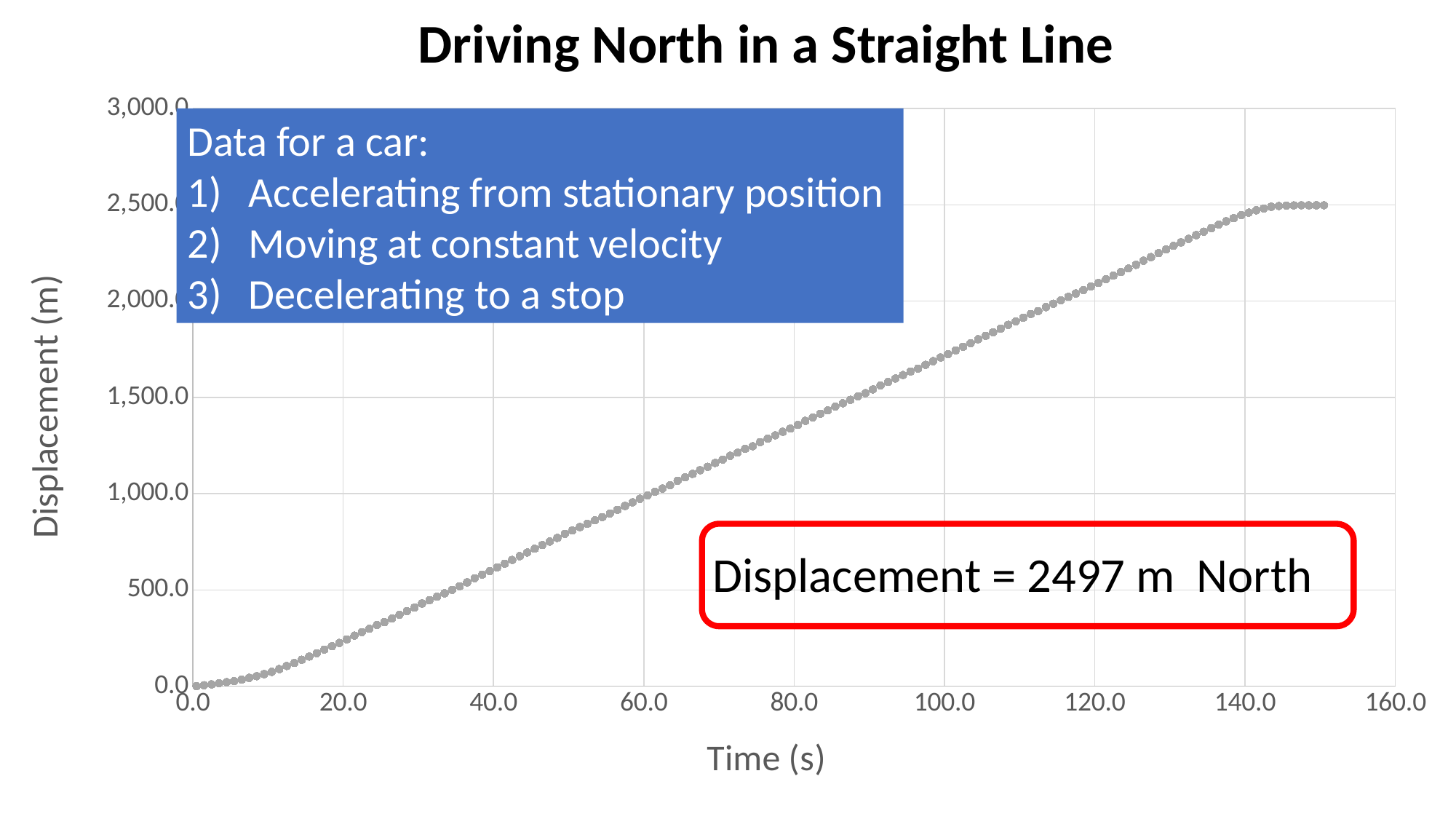
Is the displacement at 40.0 s greater or less than 500.0 m? greater Is the displacement at 100.0 s greater or less than 1,500.0 m? greater According to the annotation on the chart, what is the final displacement of the car? 2497 m North What kind of chart is shown on the slide? scatter chart Is the displacement at 80.0 s greater or less than 1,500.0 m? less Do the plotted displacement values rise or fall as time increases along the x axis? rise Which is larger, the displacement at 60.0 s or the displacement at 120.0 s? 120.0 s What is the label of the vertical axis? Displacement (m) What is the title of the chart? Driving North in a Straight Line